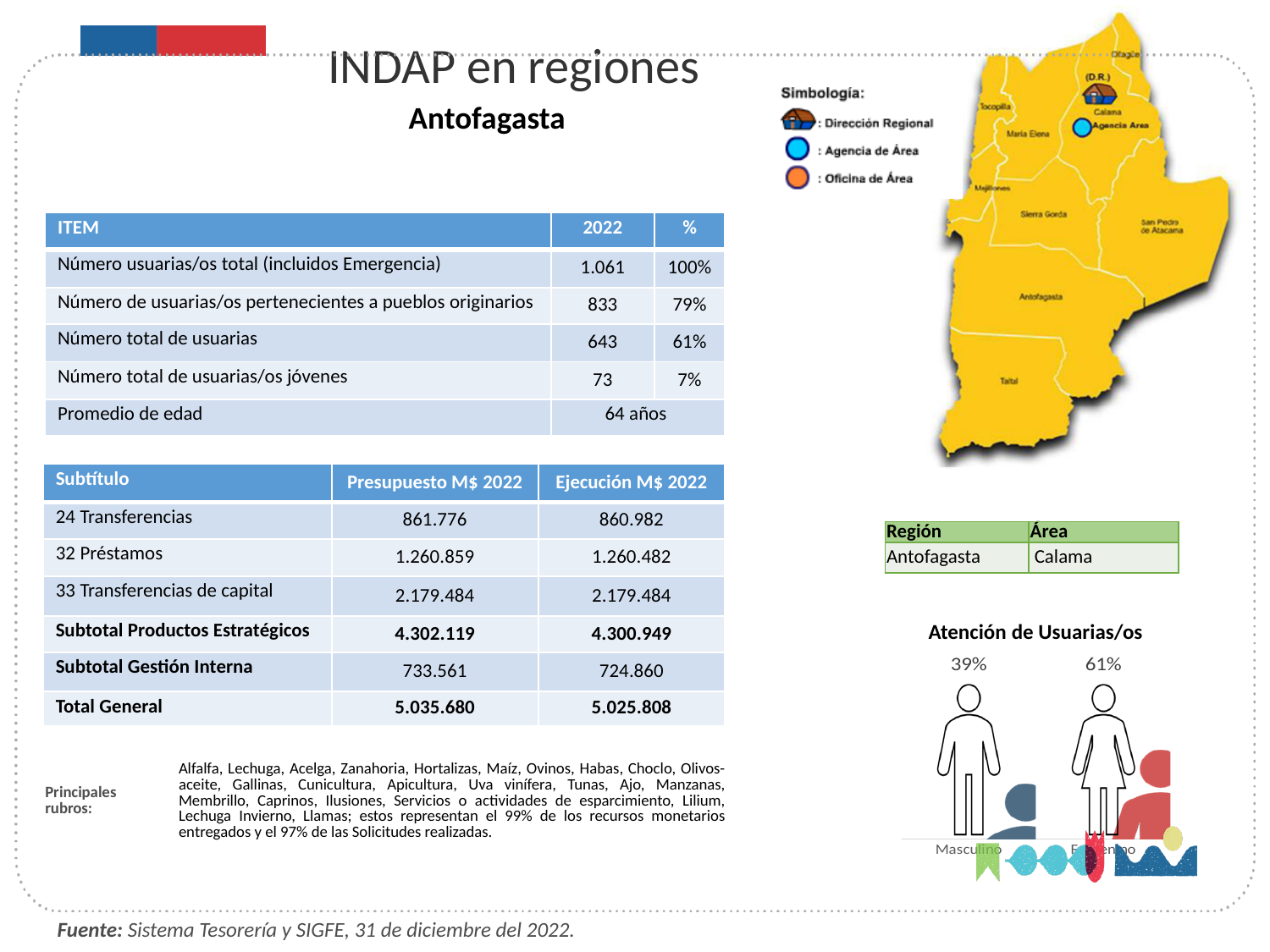
In the 'Atención de Usuarias/os' chart, what is the value for Femenino? 61% In the 'Atención de Usuarias/os' chart, which is larger, Masculino or Femenino? Femenino In the 'Atención de Usuarias/os' chart, what is the value for Masculino? 39% In the 'Atención de Usuarias/os' chart, what is the difference between the Femenino and Masculino values? 22% In the 'Atención de Usuarias/os' chart, which category has the highest value? Femenino In the 'Atención de Usuarias/os' chart, what do the Masculino and Femenino values add up to? 100% In the 'Atención de Usuarias/os' chart, which category has the lowest value? Masculino In the 'Atención de Usuarias/os' chart, is the value for Masculino greater or less than 50%? less How many categories are shown in the 'Atención de Usuarias/os' chart? 2 What is the title of the chart on the lower right of the slide? Atención de Usuarias/os In the 'Atención de Usuarias/os' chart, is the value for Femenino greater or less than 50%? greater